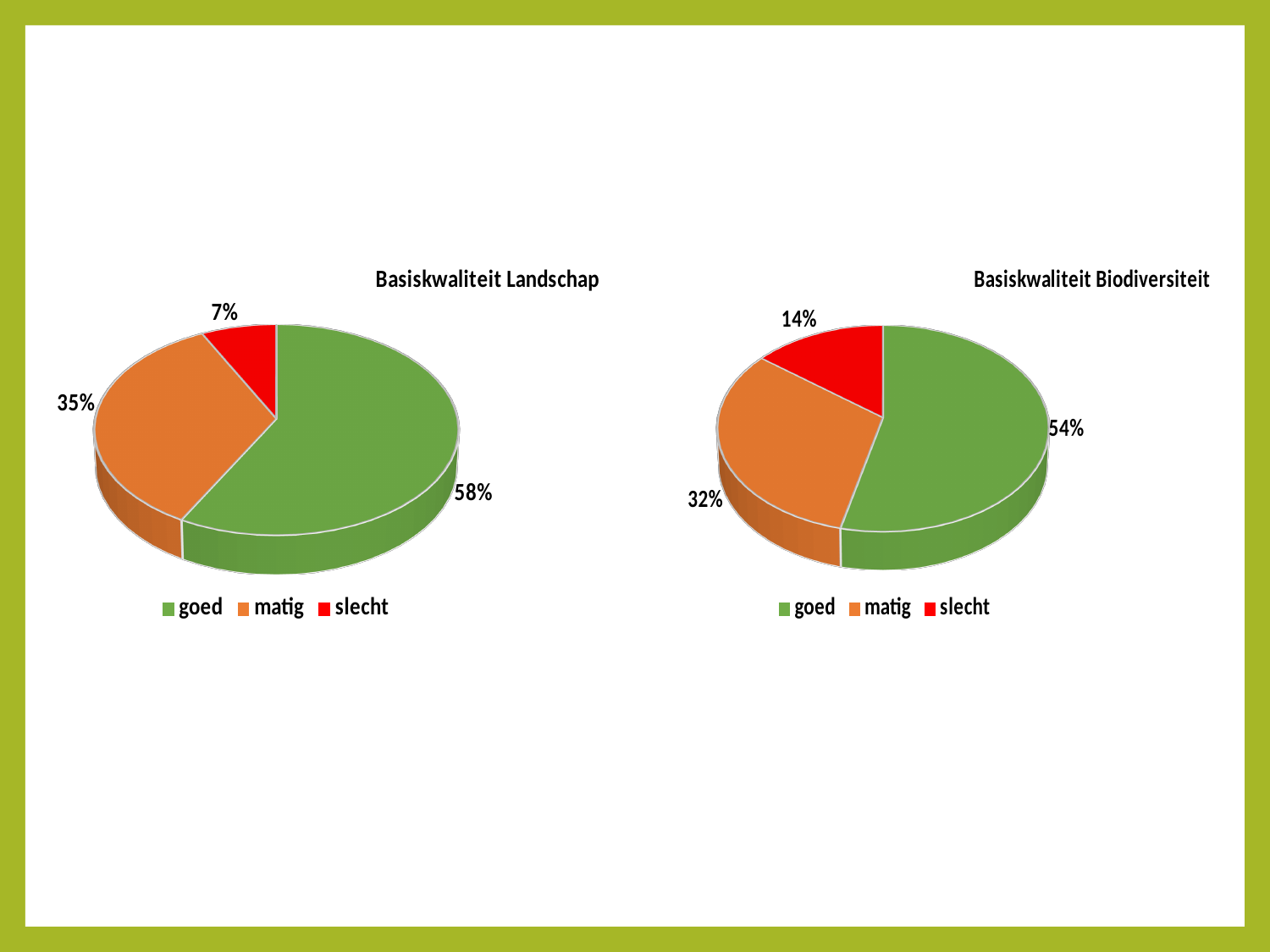
In the 'Basiskwaliteit Biodiversiteit' chart, what share is labelled for 'goed'? 54% In the 'Basiskwaliteit Biodiversiteit' chart, what share is labelled for 'slecht'? 14% In the 'Basiskwaliteit Biodiversiteit' chart, which category has the smallest slice? slecht In the 'Basiskwaliteit Landschap' chart, what is the difference in percentage points between 'goed' and 'matig'? 23 In the 'Basiskwaliteit Biodiversiteit' chart, what colour is the 'matig' slice? orange What kind of chart is 'Basiskwaliteit Biodiversiteit'? pie chart In the 'Basiskwaliteit Landschap' chart, what share is labelled for 'goed'? 58% In the 'Basiskwaliteit Landschap' chart, which category has the largest slice? goed In the 'Basiskwaliteit Landschap' chart, what share is labelled for 'slecht'? 7% In the 'Basiskwaliteit Landschap' chart, what share is labelled for 'matig'? 35% Is the 'slecht' share larger in the 'Basiskwaliteit Landschap' chart or in the 'Basiskwaliteit Biodiversiteit' chart? Basiskwaliteit Biodiversiteit How many categories does the legend of the 'Basiskwaliteit Landschap' chart list? 3